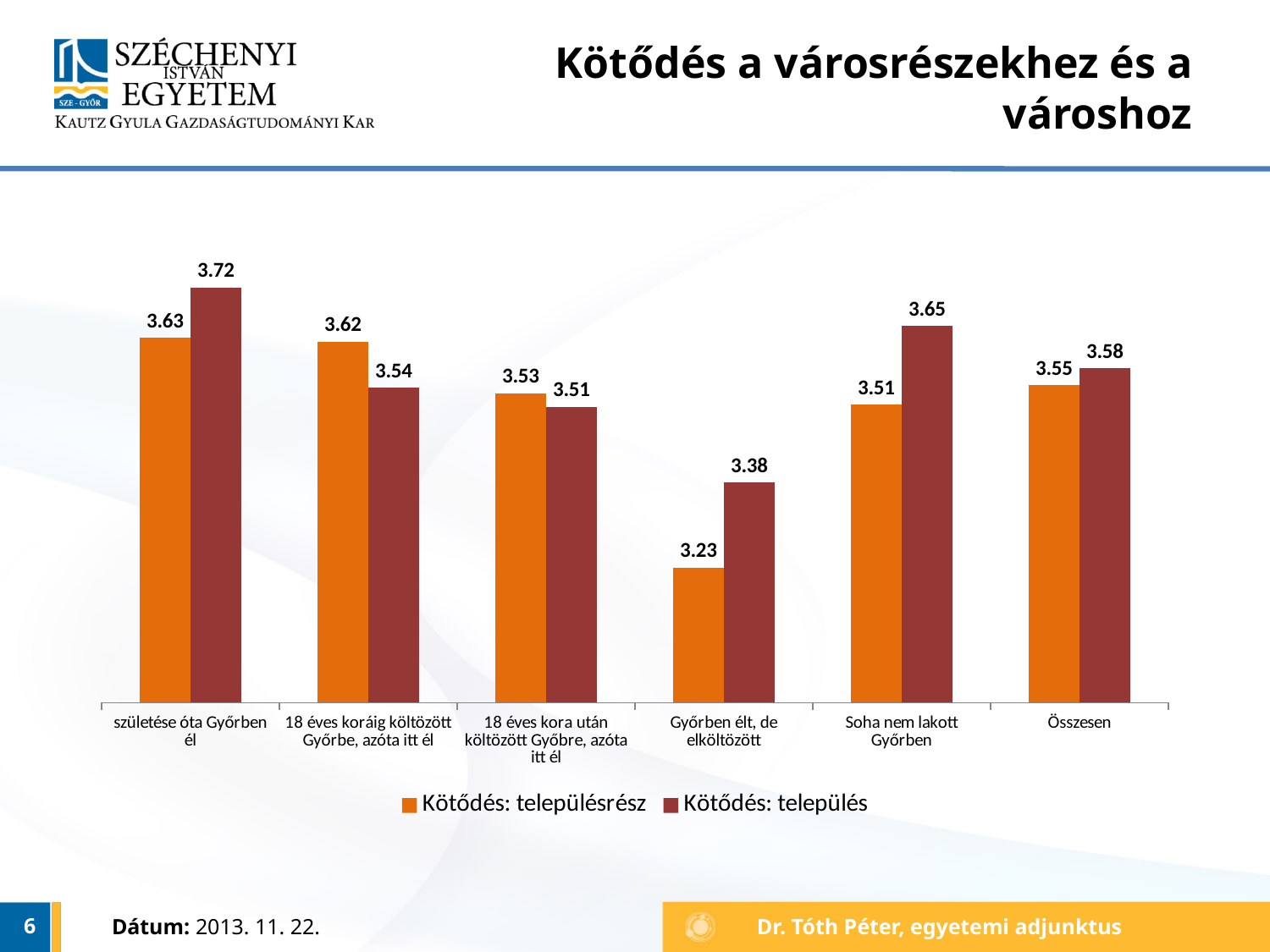
What kind of chart is shown on the slide? bar chart What is the value of "Kötődés: településrész" for "Győrben élt, de elköltözött"? 3.23 What is the value of "Kötődés: település" for "Összesen"? 3.58 Which category has the highest value for "Kötődés: település"? születése óta Győrben él What is the value of "Kötődés: településrész" for "születése óta Győrben él"? 3.63 What is the difference between "Kötődés: település" and "Kötődés: településrész" for "Győrben élt, de elköltözött"? 0.15 How many series does the legend list? 2 Which category has the lowest value for "Kötődés: településrész"? Győrben élt, de elköltözött What is the difference between "Kötődés: település" and "Kötődés: településrész" for "Soha nem lakott Győrben"? 0.14 For "18 éves koráig költözött Győrbe, azóta itt él", which is larger: "Kötődés: településrész" or "Kötődés: település"? Kötődés: településrész What is the value of "Kötődés: település" for "Soha nem lakott Győrben"? 3.65 How many categories are shown on the x axis of the chart? 6